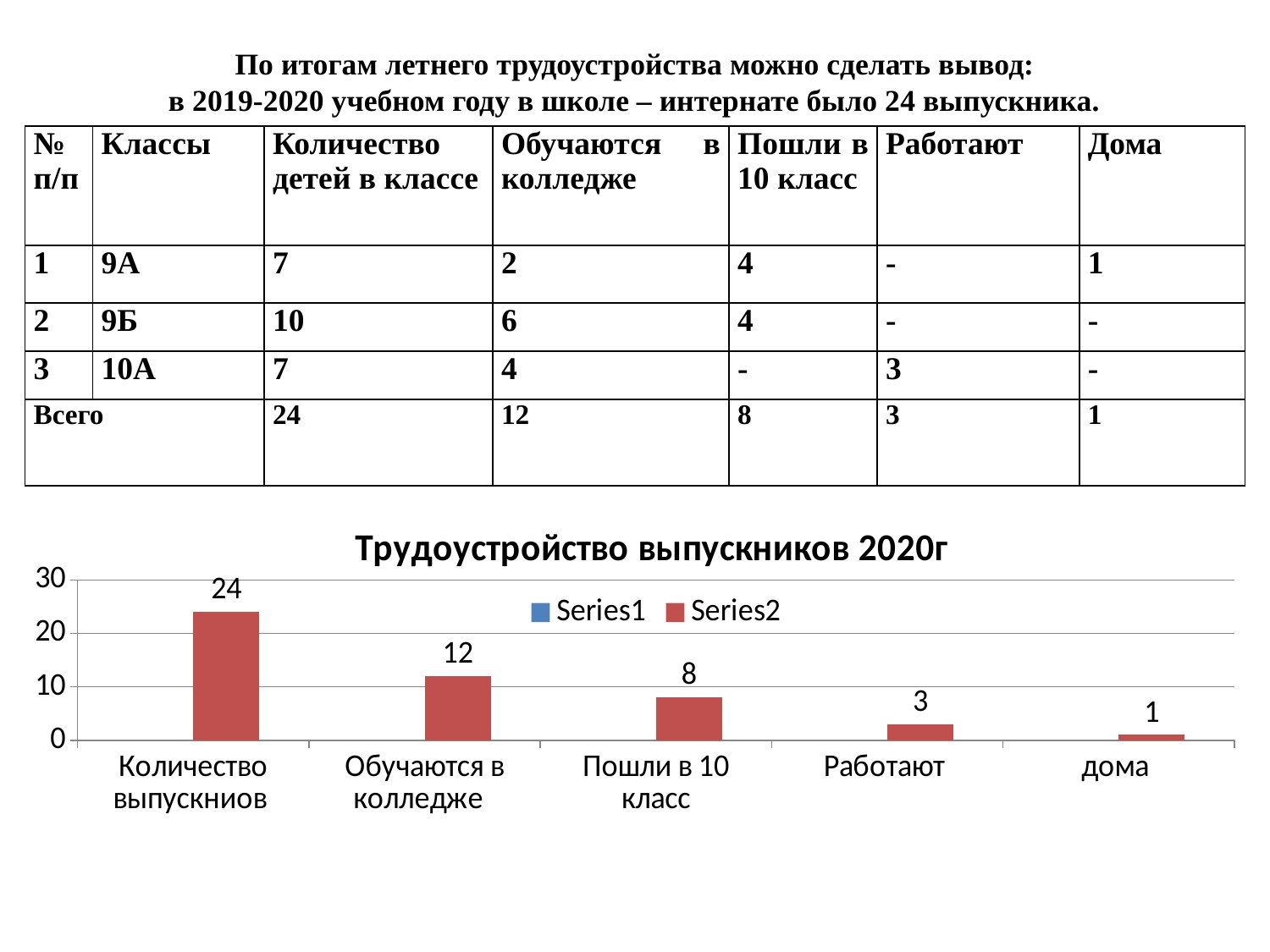
What is the title of the chart? Трудоустройство выпускников 2020г How many categories are shown on the x axis of the chart? 5 Which category has the highest value in the chart? Количество выпускниов Is the value for Обучаются в колледже greater or less than 10? greater What is the value for Работают in the chart? 3 Which category has the lowest value in the chart? дома What is the value for Обучаются в колледже in the chart? 12 Which is larger, the value for Пошли в 10 класс or the value for Работают? Пошли в 10 класс How many series does the chart legend list? 2 What is the value for Количество выпускниов in the chart? 24 What kind of chart is shown on the slide? bar chart What is the difference between the values for Обучаются в колледже and Пошли в 10 класс? 4